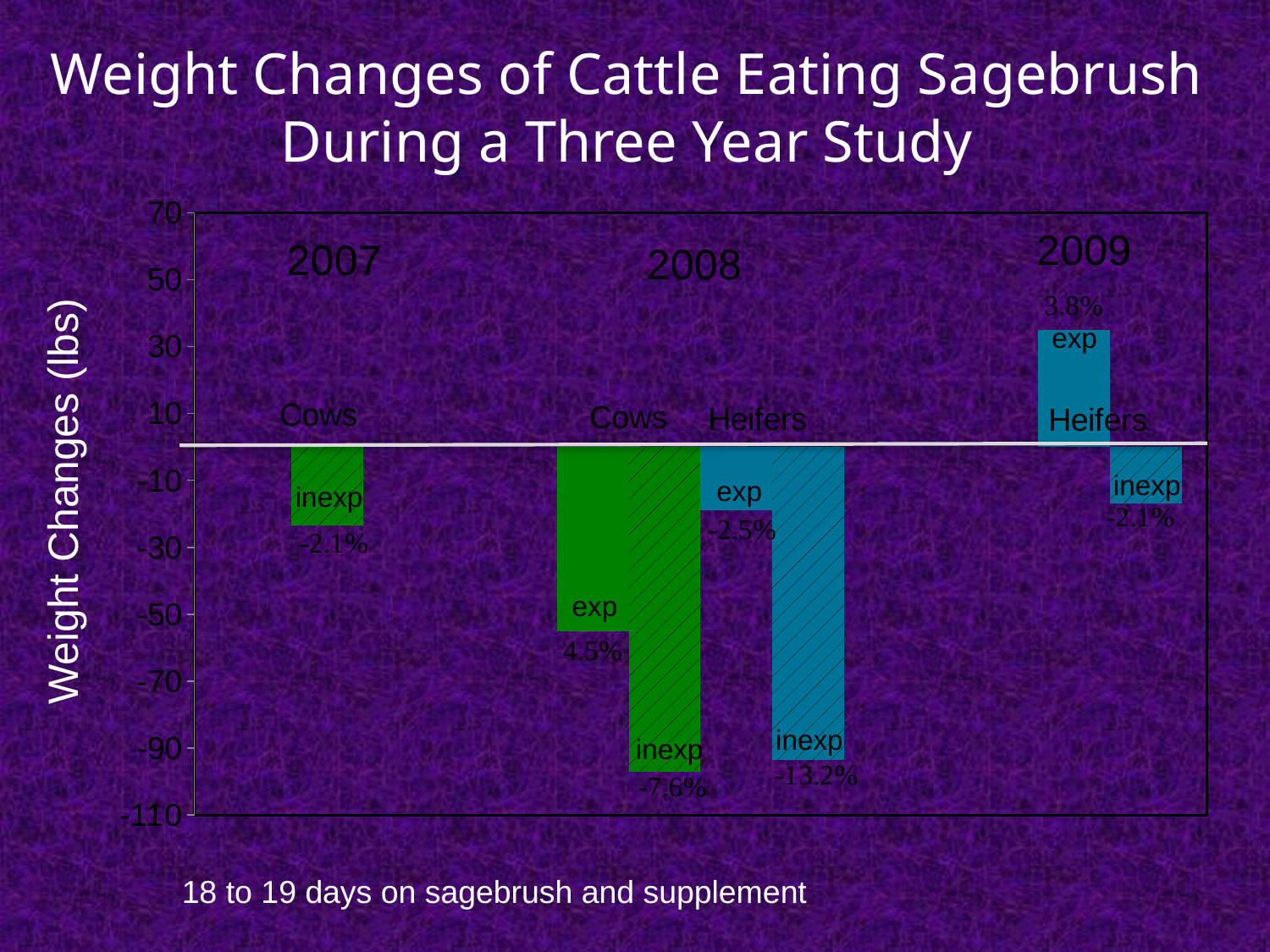
In 2008, which group lost more weight, the experienced (exp) cows or the experienced (exp) heifers? experienced (exp) cows What percentage label is shown for the inexperienced (inexp) cows in 2007? -2.1% Which group is the only one showing a positive weight change (bar above zero)? 2009 experienced (exp) heifers What percentage label is shown for the experienced (exp) heifers in 2009? 3.8% What percentage label is shown for the inexperienced (inexp) cows in 2008? -7.6% What is the title of the vertical axis? Weight Changes (lbs) What kind of chart is shown on the slide? bar chart Is the weight change for the inexperienced (inexp) cows in 2008 greater or less than -70 lbs? less How many years are shown in the chart? 3 What percentage label is shown for the inexperienced (inexp) heifers in 2008? -13.2% Is the weight change for the experienced (exp) heifers in 2009 greater or less than 30 lbs? greater What percentage label is shown for the experienced (exp) heifers in 2008? -2.5%